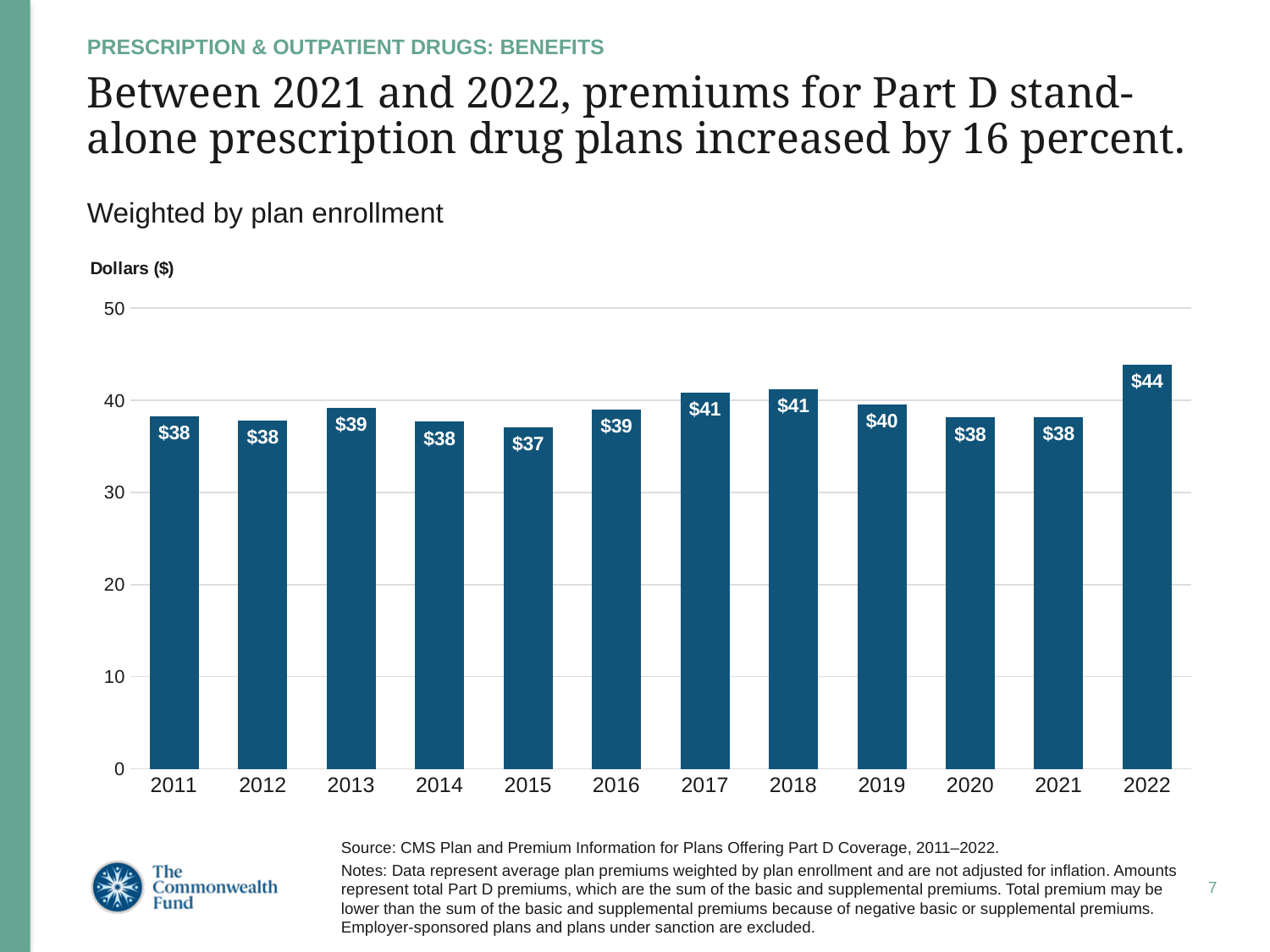
What is the value for 2019? $40 Is the value for 2022 greater or less than 40? greater What is the value for 2015? $37 Which year has the lowest value? 2015 What is the value for 2022? $44 What is the difference between the values for 2022 and 2021? $6 What is the label on the y axis? Dollars ($) What kind of chart is shown on the slide? bar chart How many years are shown on the x axis? 12 Which year has the highest value? 2022 Do the values rise or fall from 2021 to 2022? rise Which is larger, the value for 2017 or the value for 2020? 2017